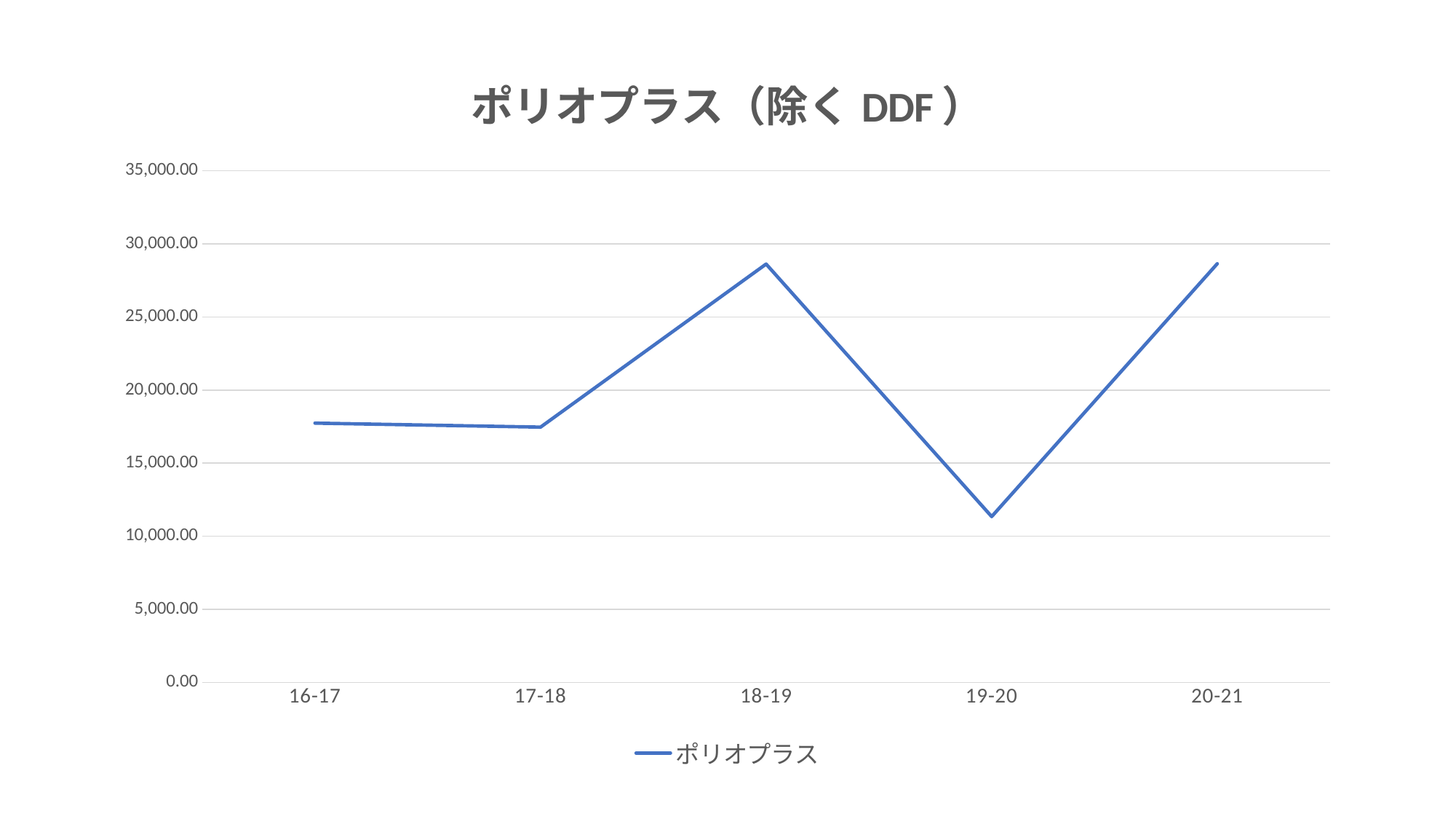
How many periods are shown on the x axis? 5 Is the value for 19-20 greater or less than 15,000.00? less What is the title of the chart? ポリオプラス（除く DDF） How many series does the legend list? 1 Which period has the lowest value for ポリオプラス? 19-20 Is the value for 20-21 greater or less than 30,000.00? less Is the value for 18-19 greater or less than 25,000.00? greater Does the value rise or fall from 19-20 to 20-21? rise What kind of chart is shown on the slide? line chart Does the value rise or fall from 18-19 to 19-20? fall Which is larger, the value for 18-19 or the value for 19-20? 18-19